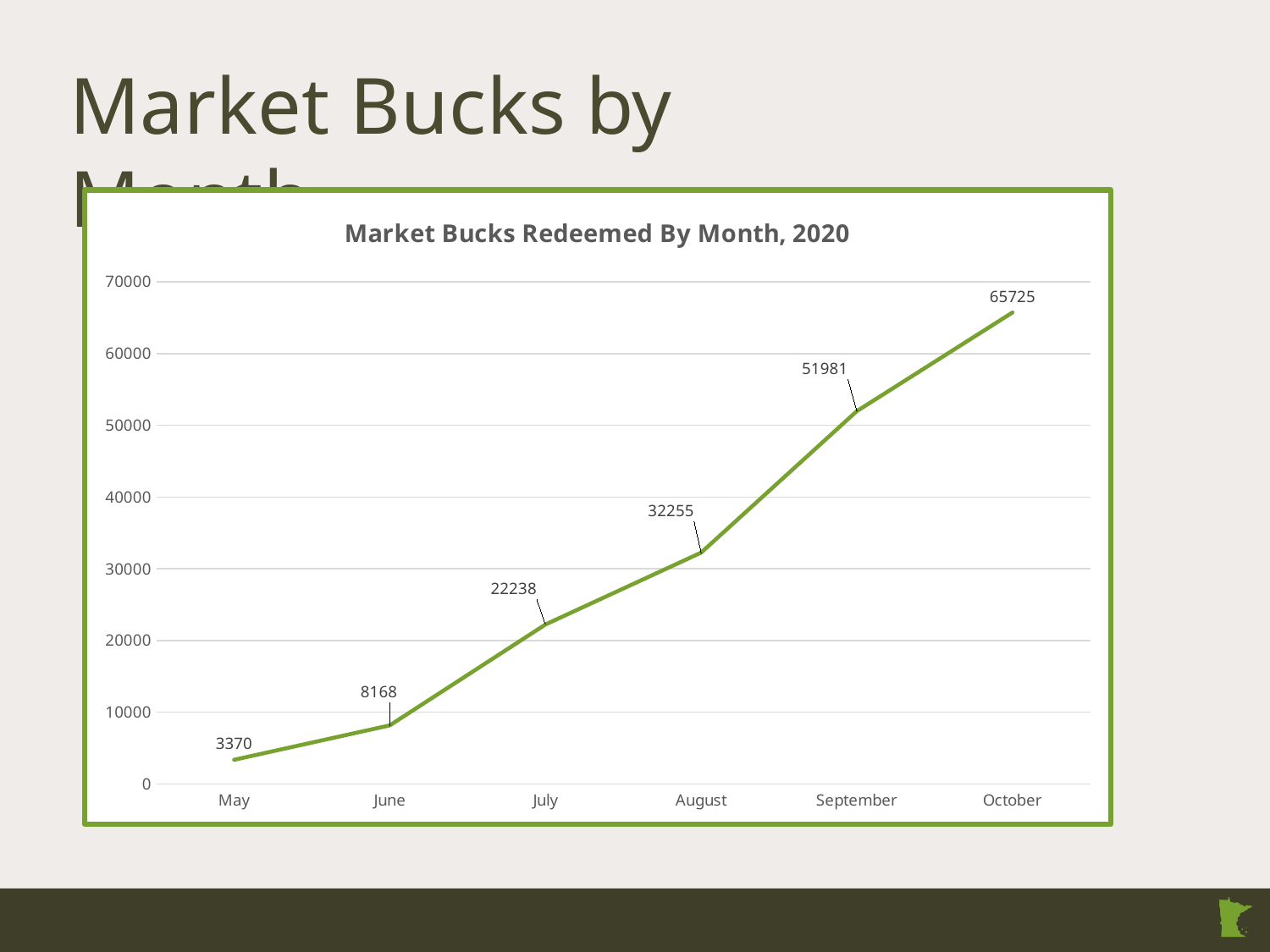
What is the value for September? 51981 What is the value for August? 32255 Which month has the lowest value? May What is the difference between the values for October and September? 13744 Is the value for July greater or less than 20000? greater What is the difference between the values for June and May? 4798 How many months are plotted on the chart? 6 What is the value for May? 3370 What kind of chart is shown? line chart Do the values rise or fall from May to October? rise Which month has the highest value? October Which is larger, the value for July or the value for August? August